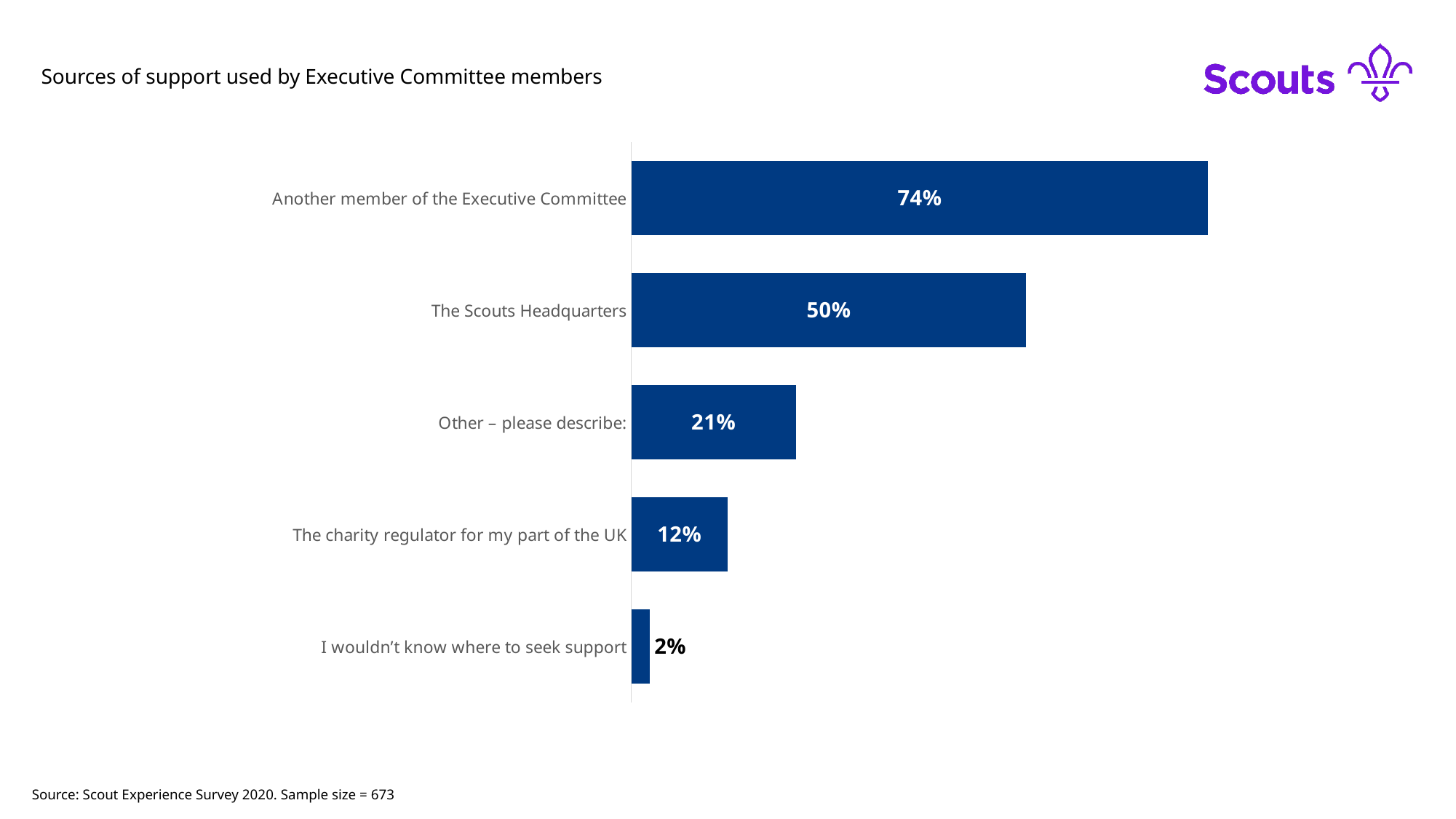
What type of chart is shown on the slide? Bar chart How many categories are shown on the chart? 5 What is the difference in percentage points between 'Another member of the Executive Committee' and 'The Scouts Headquarters'? 24 percentage points What percentage of Executive Committee members used another member of the Executive Committee as a source of support? 74% What is the title of the chart? Sources of support used by Executive Committee members What percentage of respondents said they wouldn't know where to seek support? 2% What is the value shown for The Scouts Headquarters? 50% Which source of support has the highest percentage? Another member of the Executive Committee Which category has the lowest value on the chart? I wouldn't know where to seek support What percentage is shown for 'Other – please describe:'? 21% What is the value for 'The charity regulator for my part of the UK'? 12% Which is larger: the value for 'Other – please describe:' or the value for 'The charity regulator for my part of the UK'? Other – please describe: